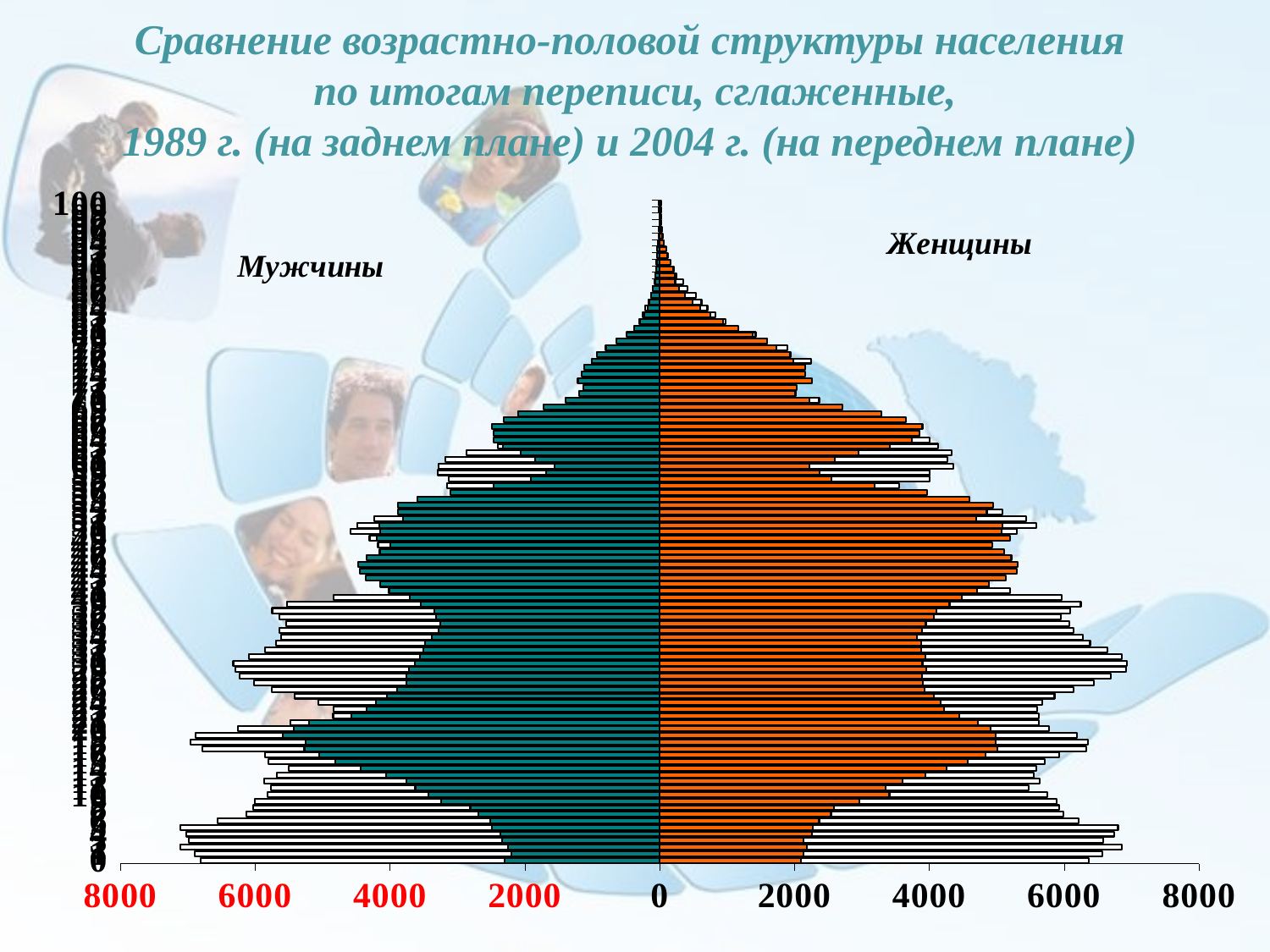
What is the largest value printed on the horizontal axis? 8000 Is the longest white (1989) bar on the Мужчины side greater or less than 6000? greater Is the longest orange bar on the Женщины side greater or less than 4000? greater According to the title, which census year is shown in the foreground (на переднем плане)? 2004 What kind of chart is shown on the slide? bar chart Are the bars at the very top of the pyramid (near age 100) greater or less than 2000? less Moving up the pyramid toward age 100, do the bar lengths generally increase or decrease? decrease Which is longer on the Женщины side: the longest white (1989) bar or the longest orange (2004) bar? the longest white (1989) bar